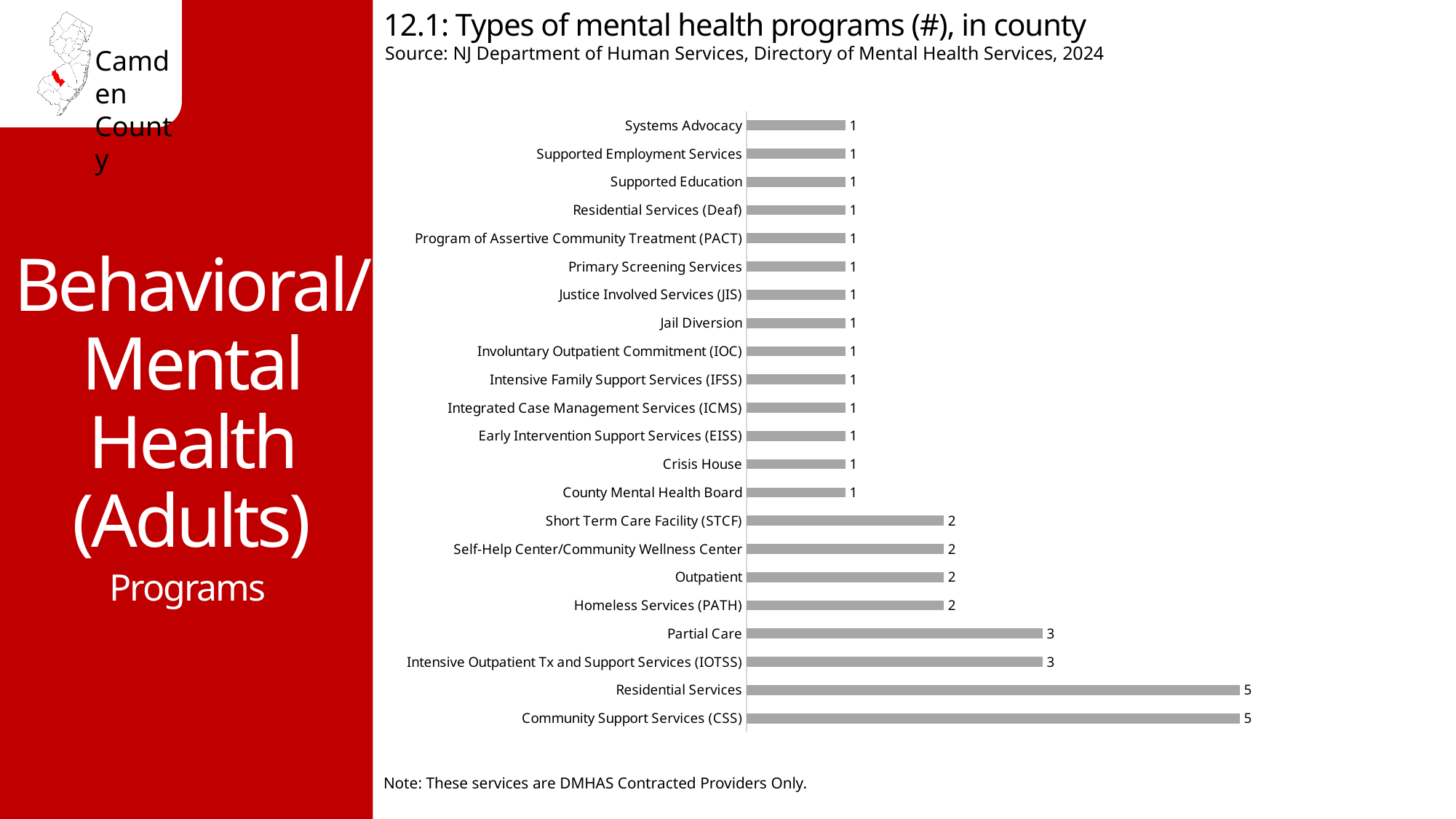
What is the value for Partial Care? 3 How many program types have a value of 2? 4 What is the value for Outpatient? 2 What is the value for Crisis House? 1 What is the title of the chart? 12.1: Types of mental health programs (#), in county What is the value for Homeless Services (PATH)? 2 How many program types does the chart list? 22 What is the highest value shown on the chart? 5 Which is larger, Short Term Care Facility (STCF) or Intensive Outpatient Tx and Support Services (IOTSS)? Intensive Outpatient Tx and Support Services (IOTSS) What is the difference between Residential Services and Partial Care? 2 What is the value for Community Support Services (CSS)? 5 What type of chart is shown on the slide? bar chart